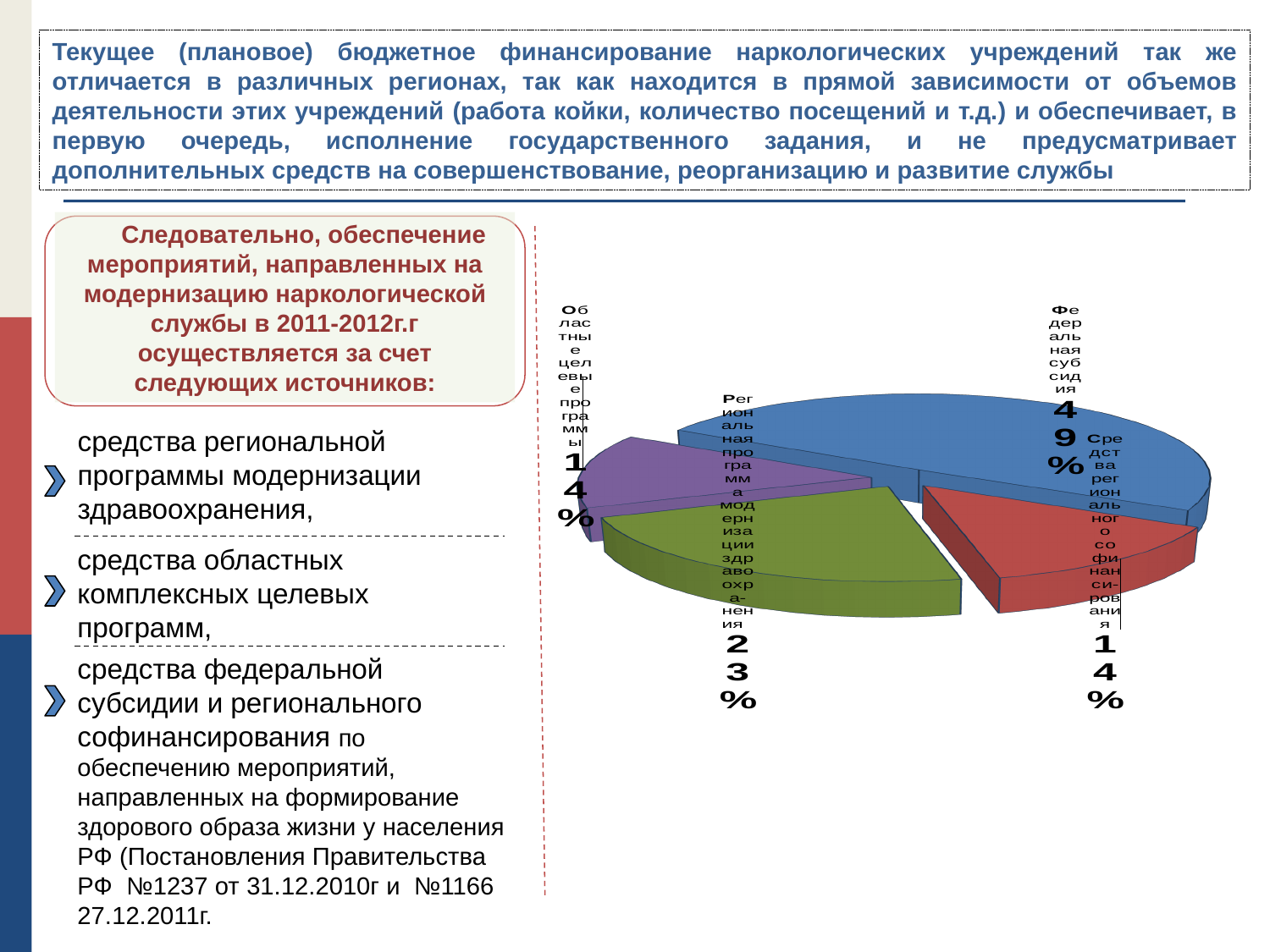
What kind of chart is shown on the slide? pie chart What share of the pie is labelled for Федеральная субсидия? 49% Which is larger: the share for Федеральная субсидия or the share for Региональная программа модернизации здравоохранения? Федеральная субсидия What is the difference between the share for Региональная программа модернизации здравоохранения and the share for Областные целевые программы? 9% Which source has the largest share of the pie? Федеральная субсидия What share of the pie is labelled for Областные целевые программы? 14% What share of the pie is labelled for Региональная программа модернизации здравоохранения? 23% What colour is the slice for Федеральная субсидия? blue What colour is the slice for Региональная программа модернизации здравоохранения? green How many slices does the pie chart have? 4 What is the difference between the share for Федеральная субсидия and the share for Региональная программа модернизации здравоохранения? 26% What share of the pie is labelled for Средства регионального софинансирования? 14%